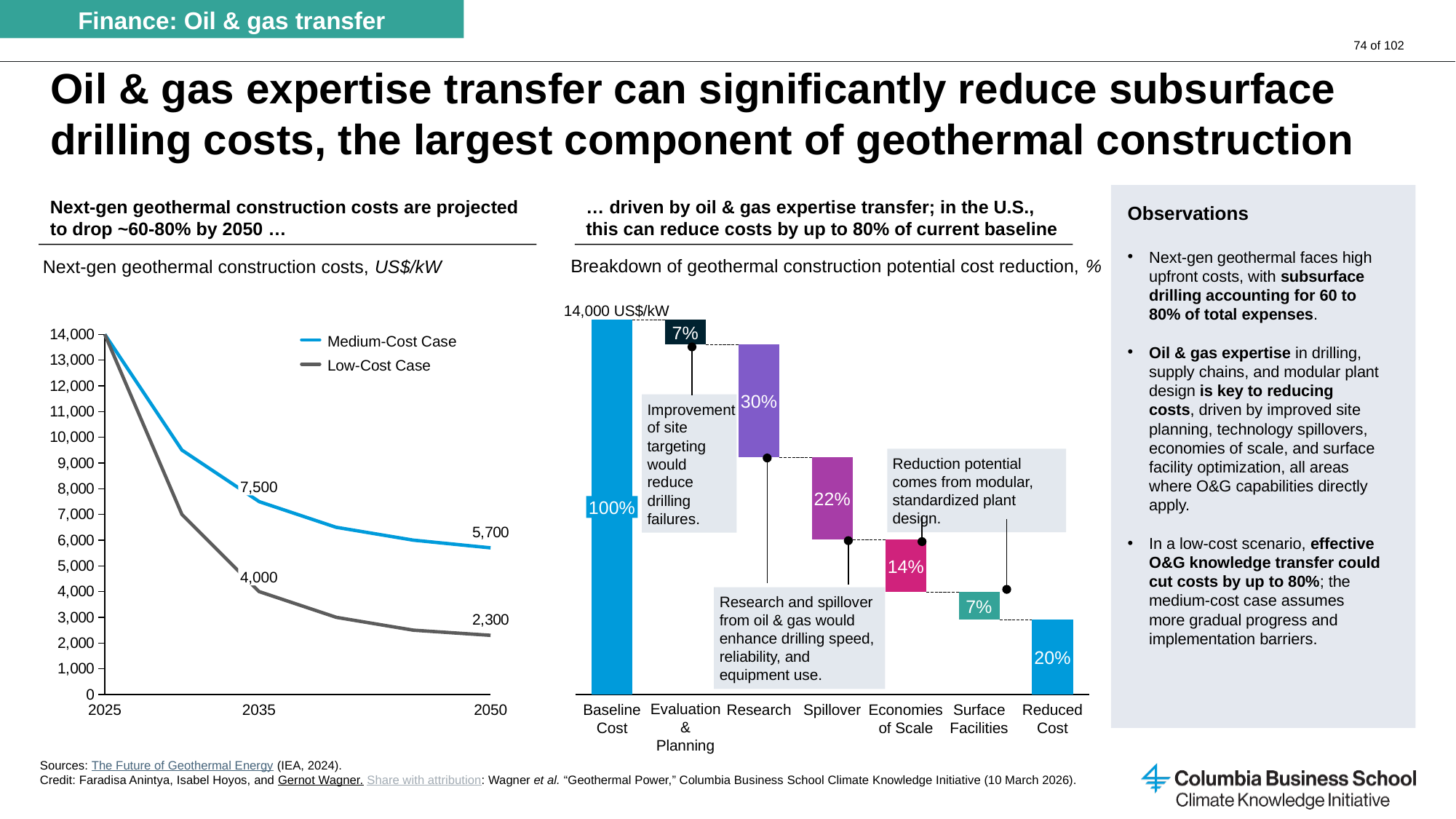
On the left chart (Next-gen geothermal construction costs), what kind of chart is it? line chart On the left chart (Next-gen geothermal construction costs), how many series does the legend list? 2 On the left chart (Next-gen geothermal construction costs), what is the Medium-Cost Case value in 2050? 5,700 On the right chart (Breakdown of geothermal construction potential cost reduction), what is the value for Research? 30% On the left chart (Next-gen geothermal construction costs), what is the Low-Cost Case value in 2035? 4,000 On the left chart (Next-gen geothermal construction costs), what is the Medium-Cost Case value in 2035? 7,500 On the left chart (Next-gen geothermal construction costs), do the values rise or fall from 2025 to 2050? fall On the left chart (Next-gen geothermal construction costs), what is the difference between the Medium-Cost Case and Low-Cost Case values in 2050? 3,400 On the right chart (Breakdown of geothermal construction potential cost reduction), which is larger, Spillover or Economies of Scale? Spillover On the right chart (Breakdown of geothermal construction potential cost reduction), which reduction category has the largest share? Research On the right chart (Breakdown of geothermal construction potential cost reduction), what is the value for Reduced Cost? 20% On the right chart (Breakdown of geothermal construction potential cost reduction), what is the value for Economies of Scale? 14%